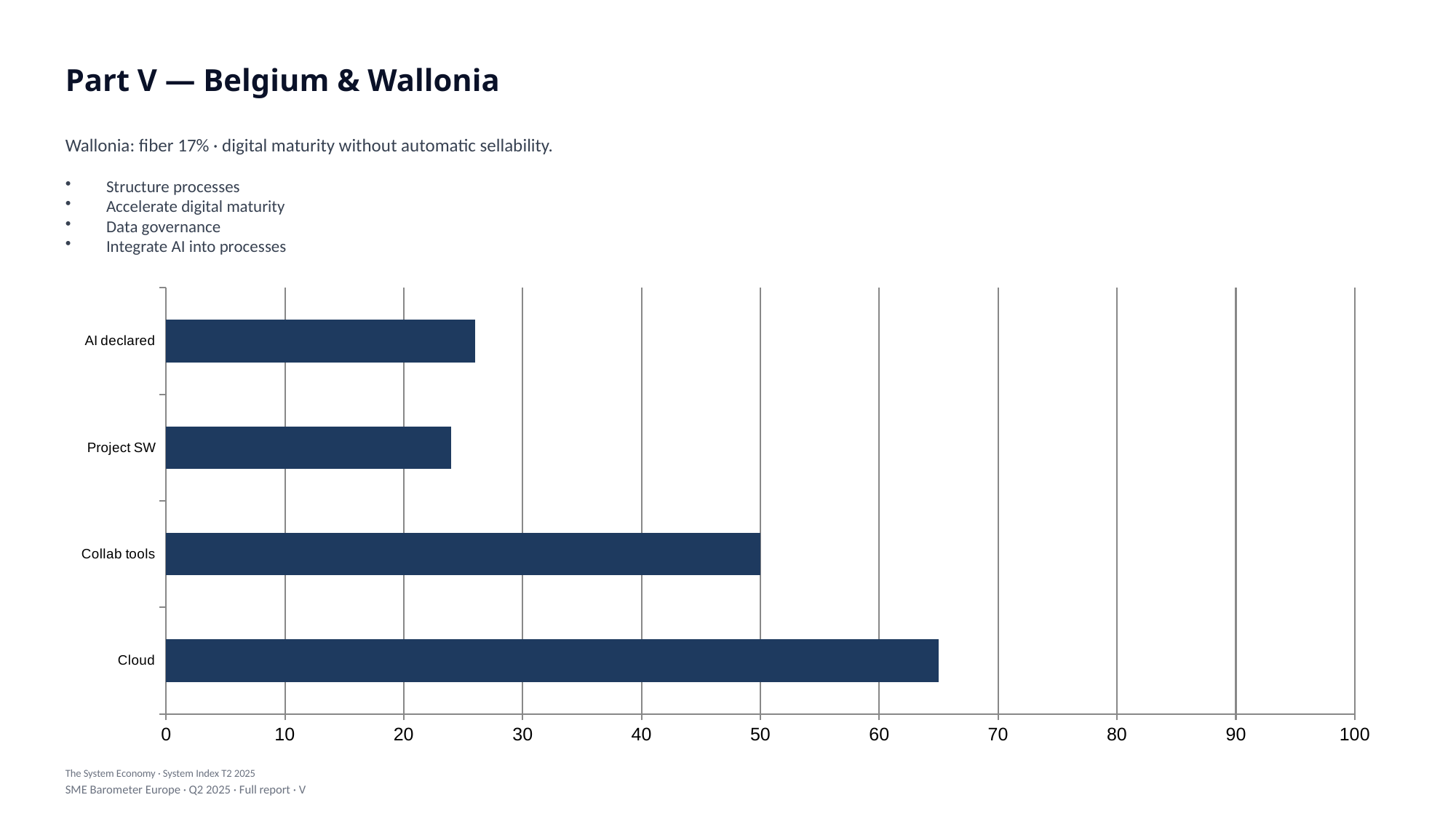
Which category has the highest value in the chart? Cloud Is the value for AI declared greater or less than 30? less Is the value for Cloud greater or less than 60? greater Is the value for Project SW greater or less than 20? greater Which is larger, the value for Cloud or the value for Collab tools? Cloud What kind of chart is shown on the slide? bar chart How many categories are plotted in the chart? 4 Which is larger, the value for Collab tools or the value for AI declared? Collab tools Are the bars in the chart drawn horizontally or vertically? horizontally What is the value for Collab tools? 50